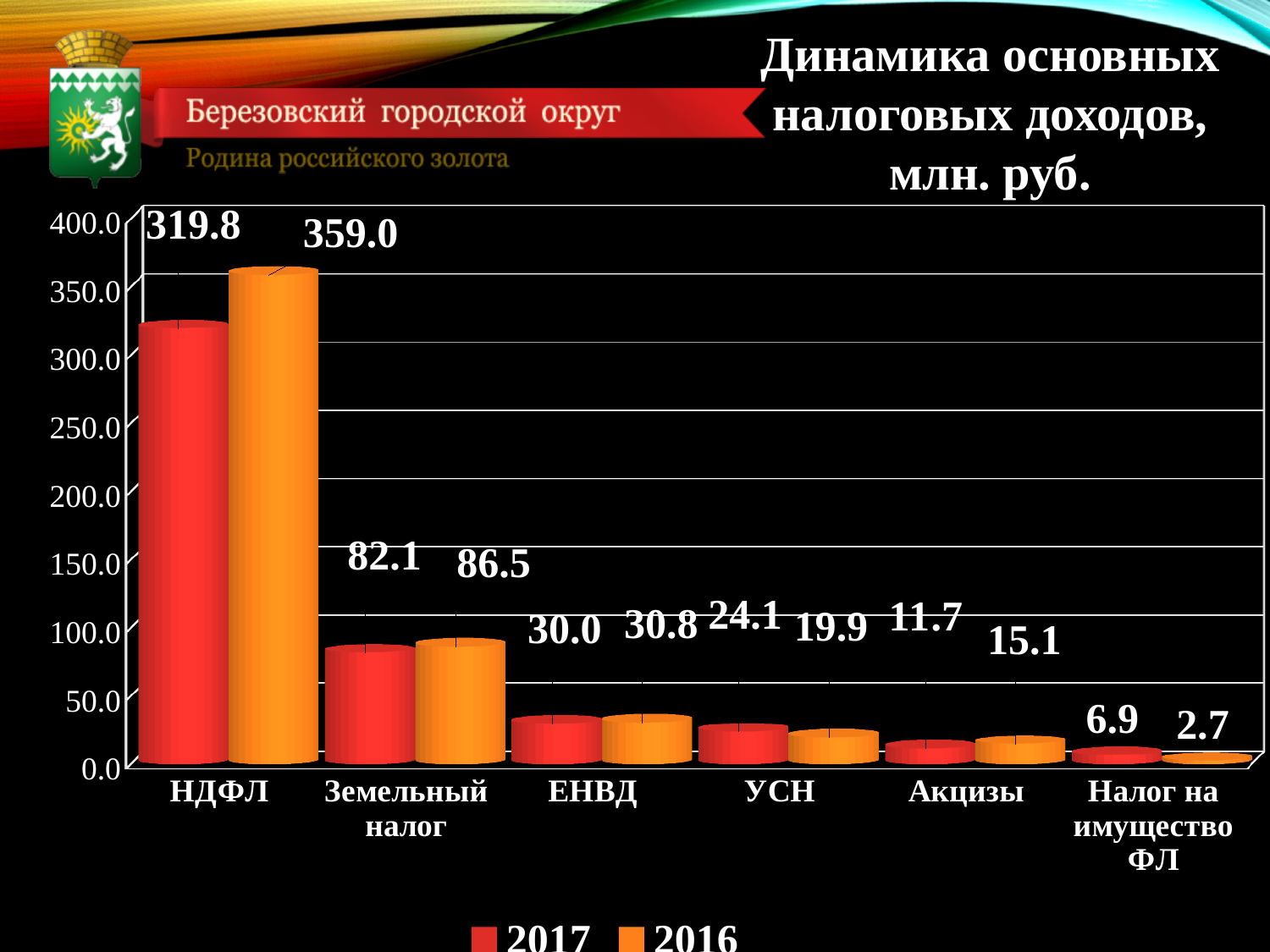
What is the 2017 value for Налог на имущество ФЛ? 6.9 Is the 2017 value for Земельный налог greater or less than 100.0? less Which category has the lowest 2017 value? Налог на имущество ФЛ What is the 2016 value for УСН? 19.9 How many series does the legend list? 2 Which is larger for Акцизы, the 2017 value or the 2016 value? 2016 Which category has the highest 2016 value? НДФЛ What is the 2016 value for Земельный налог? 86.5 What is the difference between the 2016 and 2017 values for НДФЛ? 39.2 What kind of chart is shown on the slide? bar chart What is the 2017 value for НДФЛ? 319.8 How many categories are shown on the x axis? 6